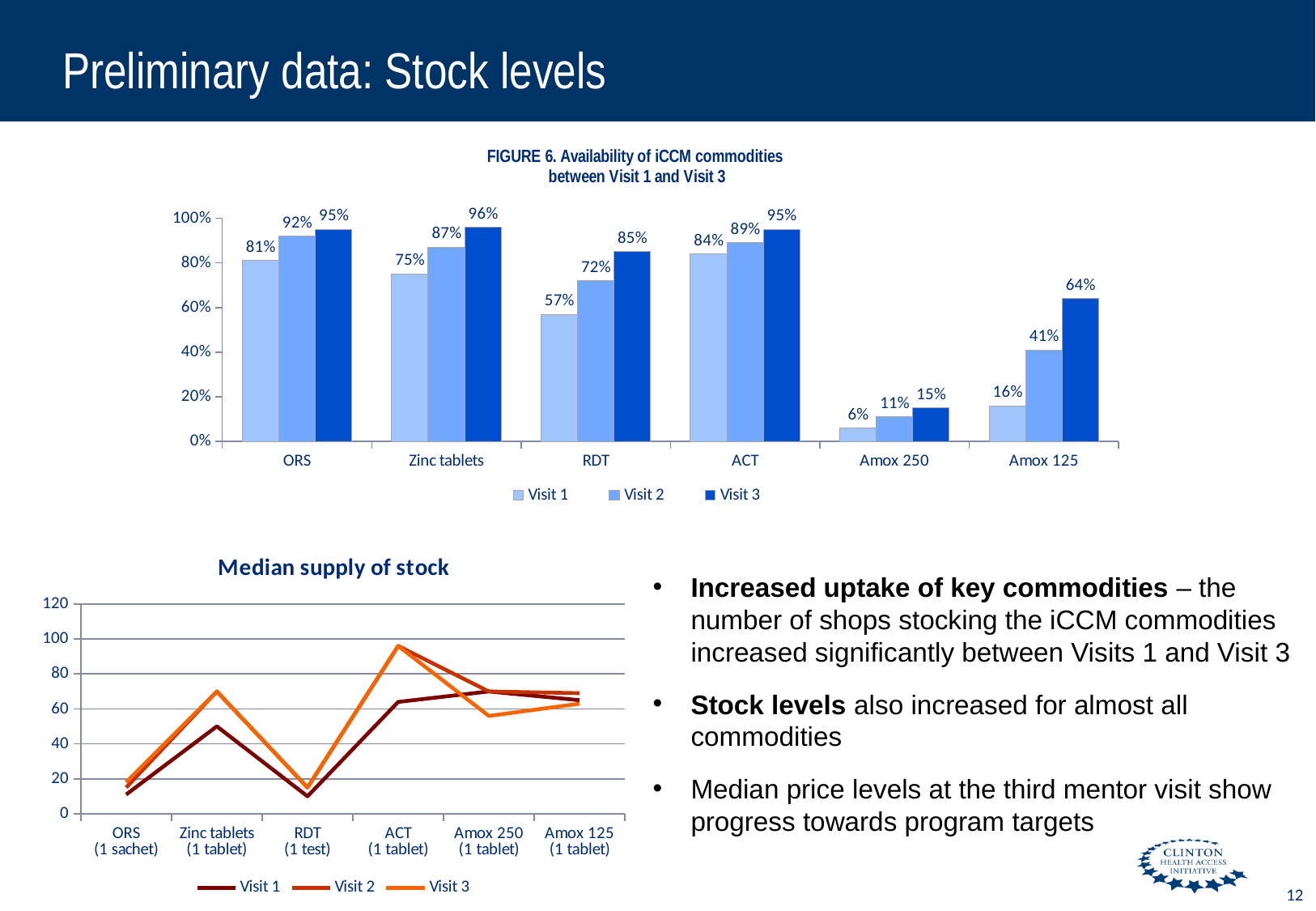
In the 'Median supply of stock' chart, is the Visit 3 value for ACT greater or less than 80? greater In the 'Availability of iCCM commodities' chart, which commodity has the highest Visit 3 value? Zinc tablets In the 'Availability of iCCM commodities' chart, which commodity has the lowest Visit 1 value? Amox 250 How many commodity categories are shown on the x axis of the 'Availability of iCCM commodities' chart? 6 In the 'Availability of iCCM commodities' chart, what is the Visit 3 value for Amox 125? 64% In the 'Median supply of stock' chart, is the Visit 1 value for RDT greater or less than 20? less What kind of chart is the 'Median supply of stock' chart? Line chart In the 'Availability of iCCM commodities' chart, which is larger: the Visit 2 value for ORS or the Visit 2 value for ACT? Visit 2 value for ORS How many series does the legend of the 'Availability of iCCM commodities' chart list? 3 In the 'Availability of iCCM commodities' chart, what is the difference between the Visit 3 and Visit 1 values for Amox 125? 48% In the 'Availability of iCCM commodities' chart, what is the Visit 1 value for RDT? 57% In the 'Median supply of stock' chart, which series is drawn in the darkest red line? Visit 1